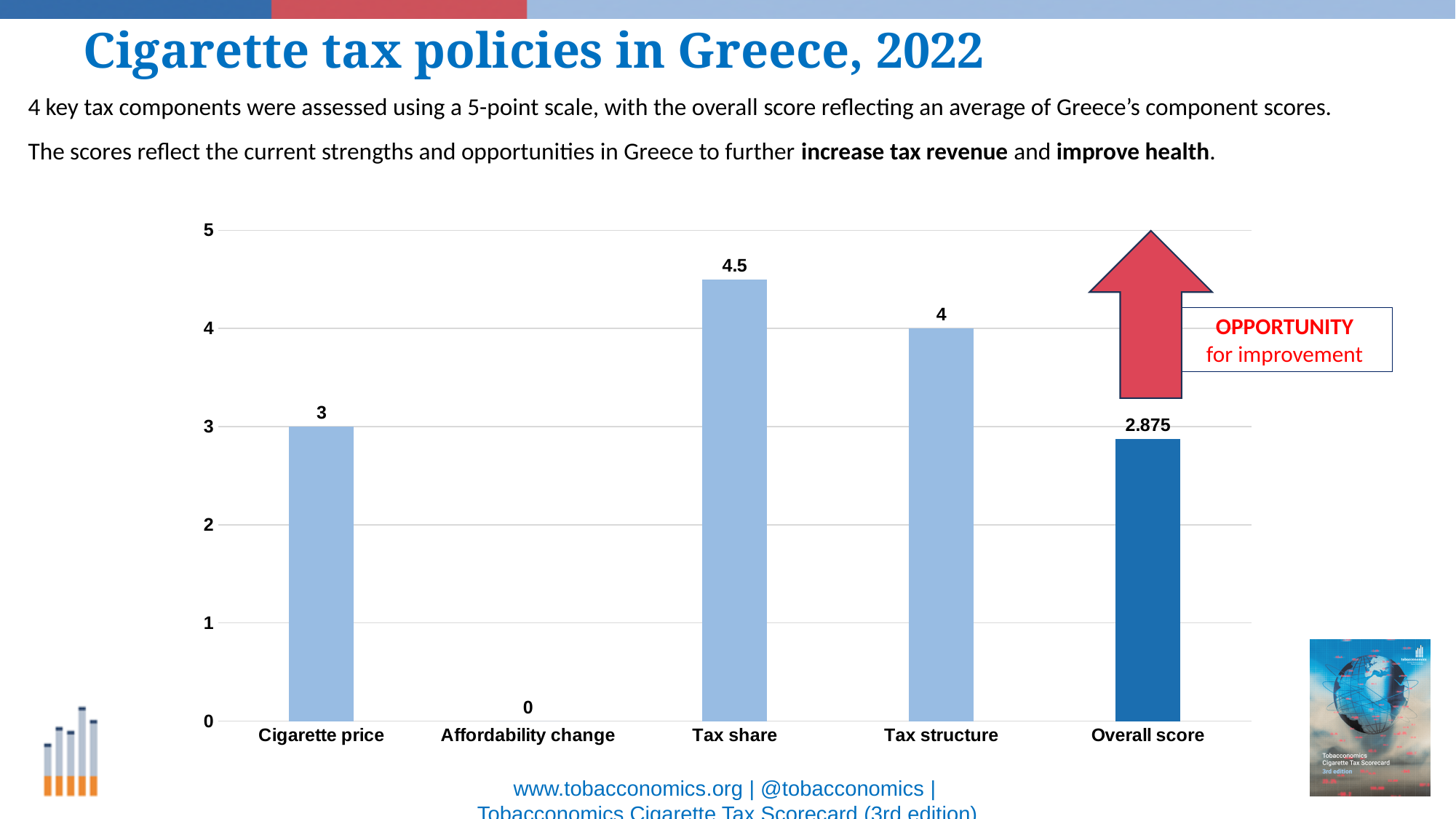
How many categories are shown on the x axis? 5 Which category has the lowest value? Affordability change What is the value for Cigarette price? 3 Which is larger, the value for Tax structure or the value for Cigarette price? Tax structure What is the value for Tax share? 4.5 What is the difference between the values for Tax share and Cigarette price? 1.5 What kind of chart is shown on the slide? Bar chart What is the Overall score? 2.875 What is the maximum value shown on the y axis? 5 What is the value for Tax structure? 4 What is the value for Affordability change? 0 Which category has the highest value? Tax share